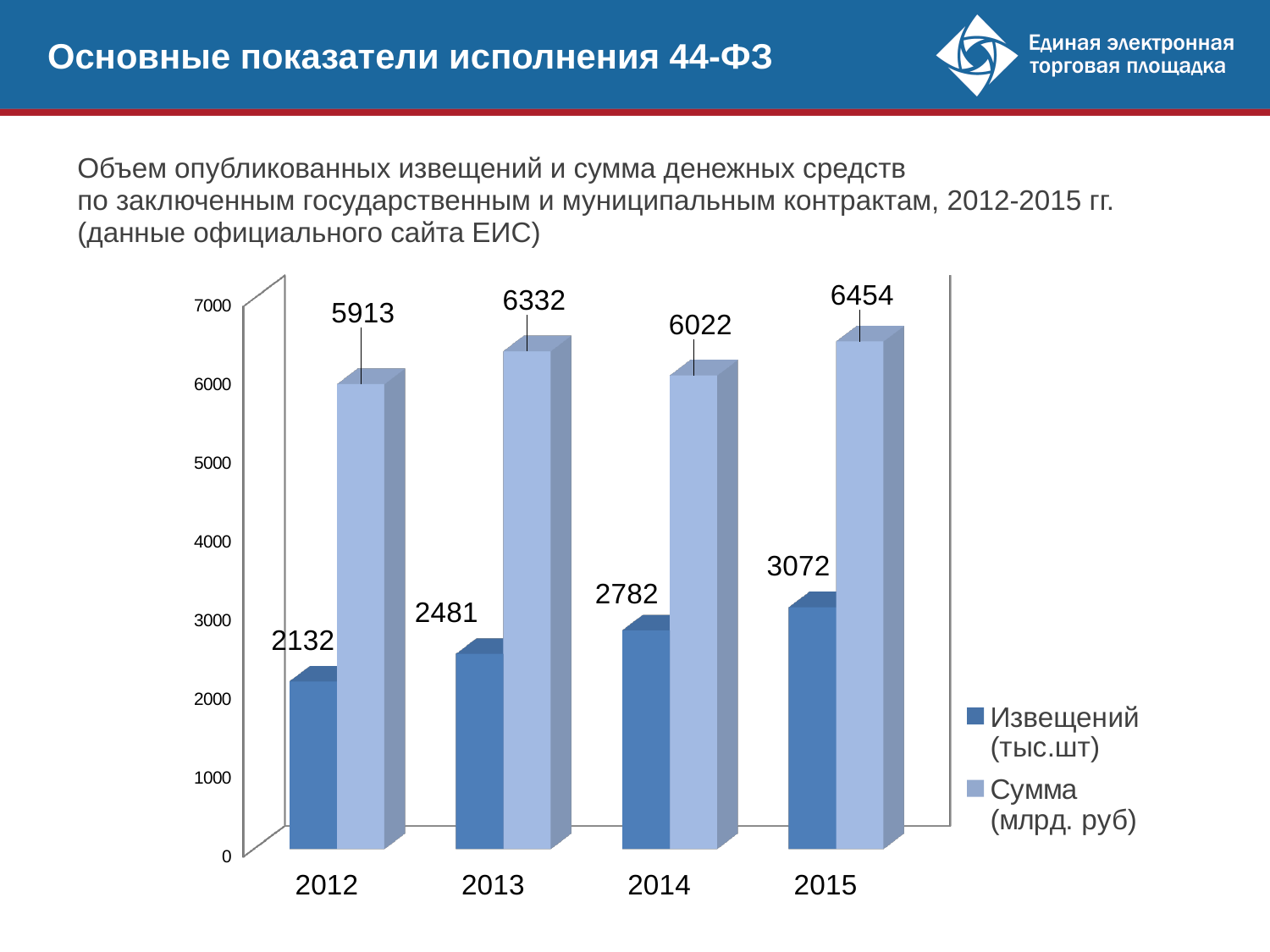
Which year has the highest value for Сумма (млрд. руб)? 2015 Which is larger: Сумма (млрд. руб) for 2013 or for 2014? 2013 What is the value of Сумма (млрд. руб) for 2014? 6022 What is the difference between the Извещений (тыс.шт) values for 2015 and 2014? 290 How many series does the legend list? 2 What is the difference between the Сумма (млрд. руб) values for 2013 and 2012? 419 What kind of chart is shown on the slide? bar chart Is the value of Извещений (тыс.шт) for 2015 greater or less than 3000? greater Which year has the lowest value for Извещений (тыс.шт)? 2012 What is the value of Извещений (тыс.шт) for 2012? 2132 What is the value of Извещений (тыс.шт) for 2015? 3072 How many years are shown on the x axis? 4